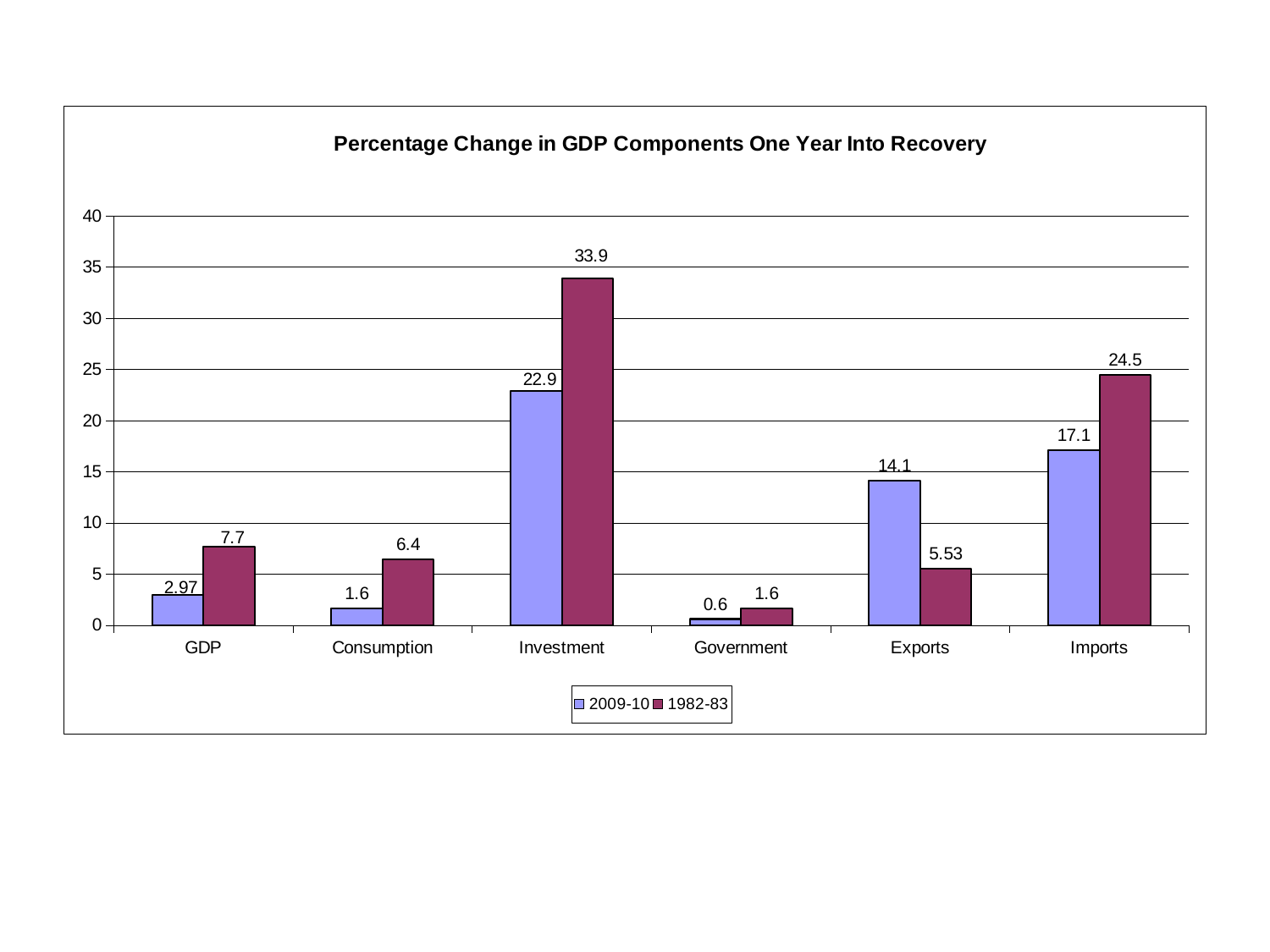
What is the value for Investment in the 2009-10 series? 22.9 What is the value for Exports in the 1982-83 series? 5.53 How many categories are shown on the x axis? 6 What is the value for GDP in the 2009-10 series? 2.97 What is the difference between the 1982-83 and 2009-10 values for Imports? 7.4 What is the title of the chart? Percentage Change in GDP Components One Year Into Recovery How many series does the legend list? 2 Is the value for Investment in the 1982-83 series greater or less than 30? greater Which category has the highest value in the 1982-83 series? Investment Which category has the lowest value in the 2009-10 series? Government Which is larger for Exports: the 2009-10 value or the 1982-83 value? 2009-10 What kind of chart is shown on the slide? bar chart